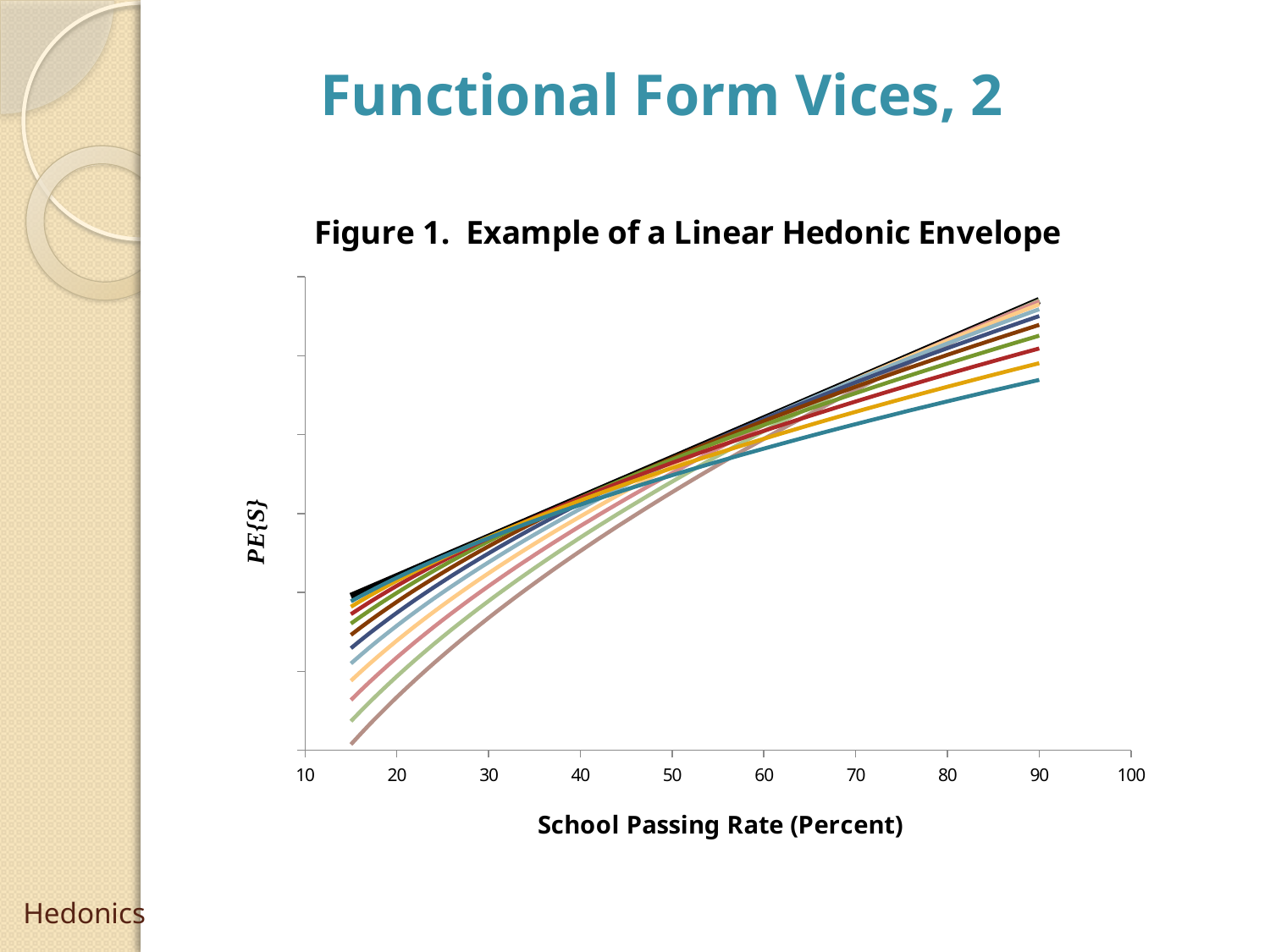
What kind of chart is shown on the slide? line chart Do the plotted lines rise or fall as the School Passing Rate increases from 10 to 100? rise What is the title of the chart on the slide? Figure 1. Example of a Linear Hedonic Envelope What is the label of the x axis of the chart? School Passing Rate (Percent)